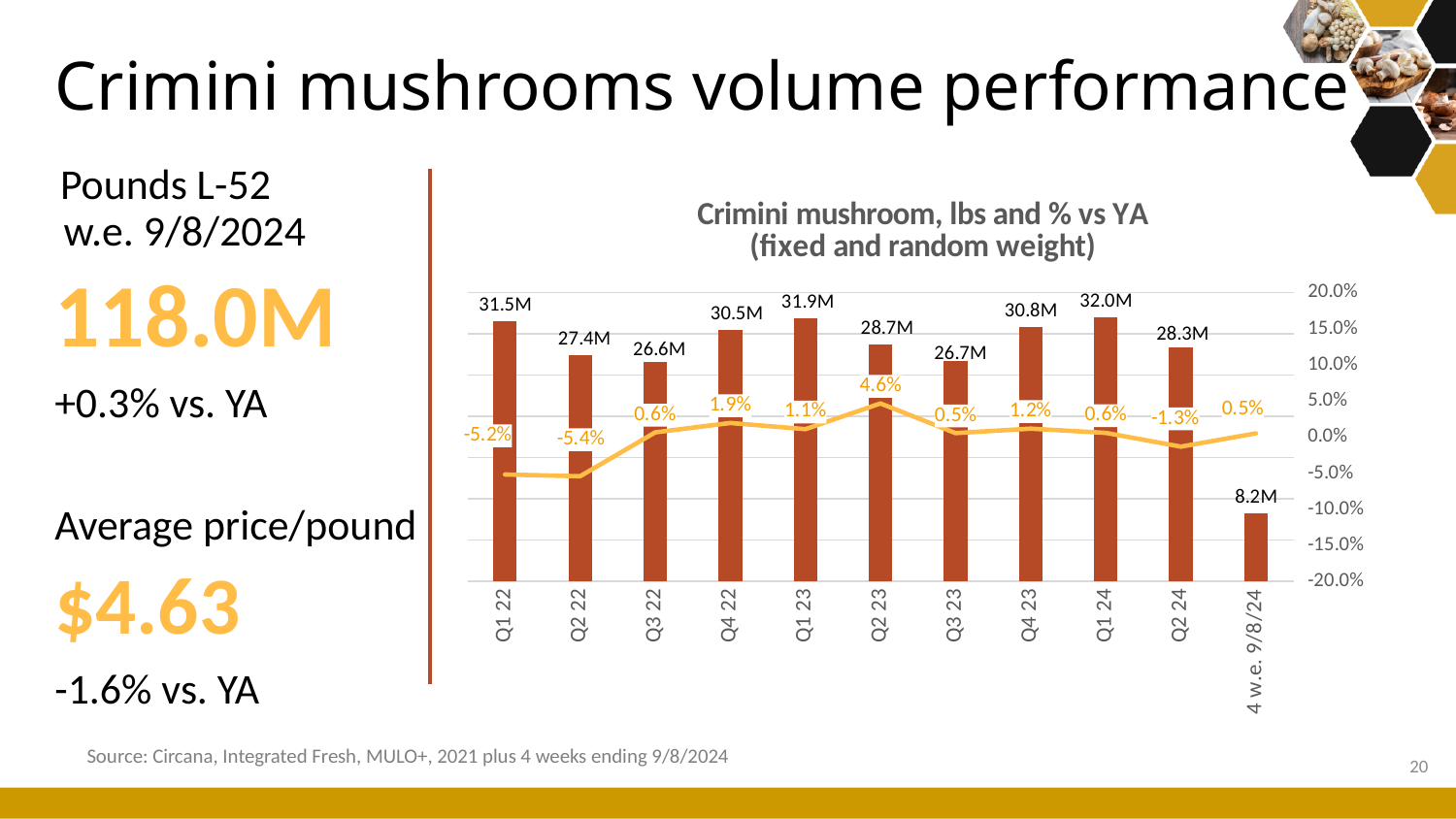
What is the difference in pounds between Q1 24 and Q2 24? 3.7M What is the title of the chart? Crimini mushroom, lbs and % vs YA (fixed and random weight) Which period has the highest pounds bar? Q1 24 How many periods are shown on the x axis of the chart? 11 Which has the larger pounds value, Q2 22 or Q3 22? Q2 22 What kind of chart is shown on the slide? Bar chart with a line Which period has the highest % vs YA value on the line? Q2 23 What is the % vs YA value shown for Q2 23? 4.6% What is the % vs YA value for Q2 24? -1.3% Which period has the lowest % vs YA value on the line? Q2 22 What is the pounds value for Q1 24 in the chart? 32.0M What is the pounds value for the 4 w.e. 9/8/24 period? 8.2M